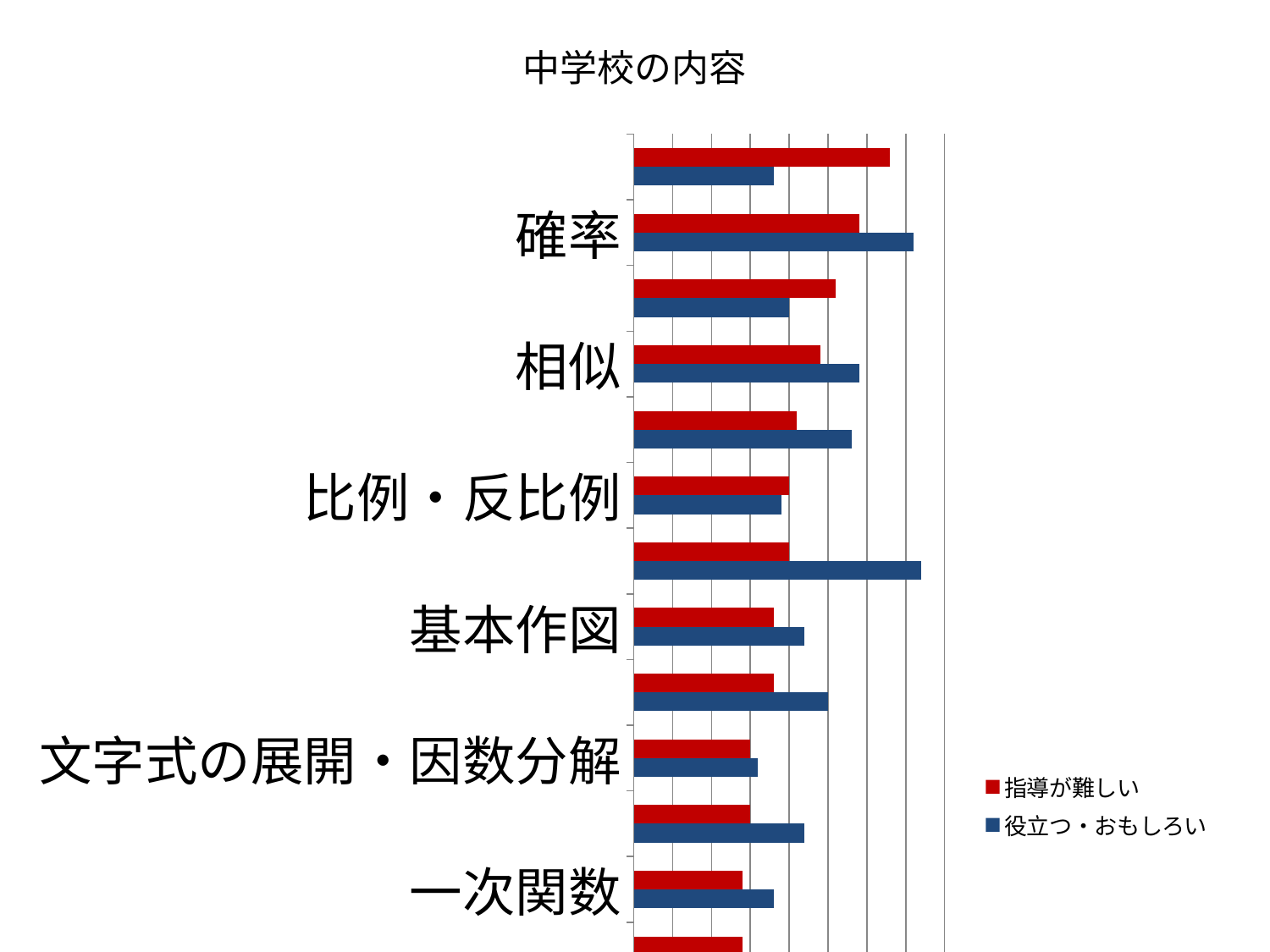
In the 指導が難しい series, which has the larger value, 相似 or 文字式の展開・因数分解? 相似 For 一次関数, which series has the larger value, 指導が難しい or 役立つ・おもしろい? 役立つ・おもしろい In the 役立つ・おもしろい series, which has the larger value, 相似 or 一次関数? 相似 What kind of chart is shown on the slide? bar chart What is the title of the chart? 中学校の内容 How many series does the legend list? 2 Which colour represents the series 指導が難しい in the chart? red